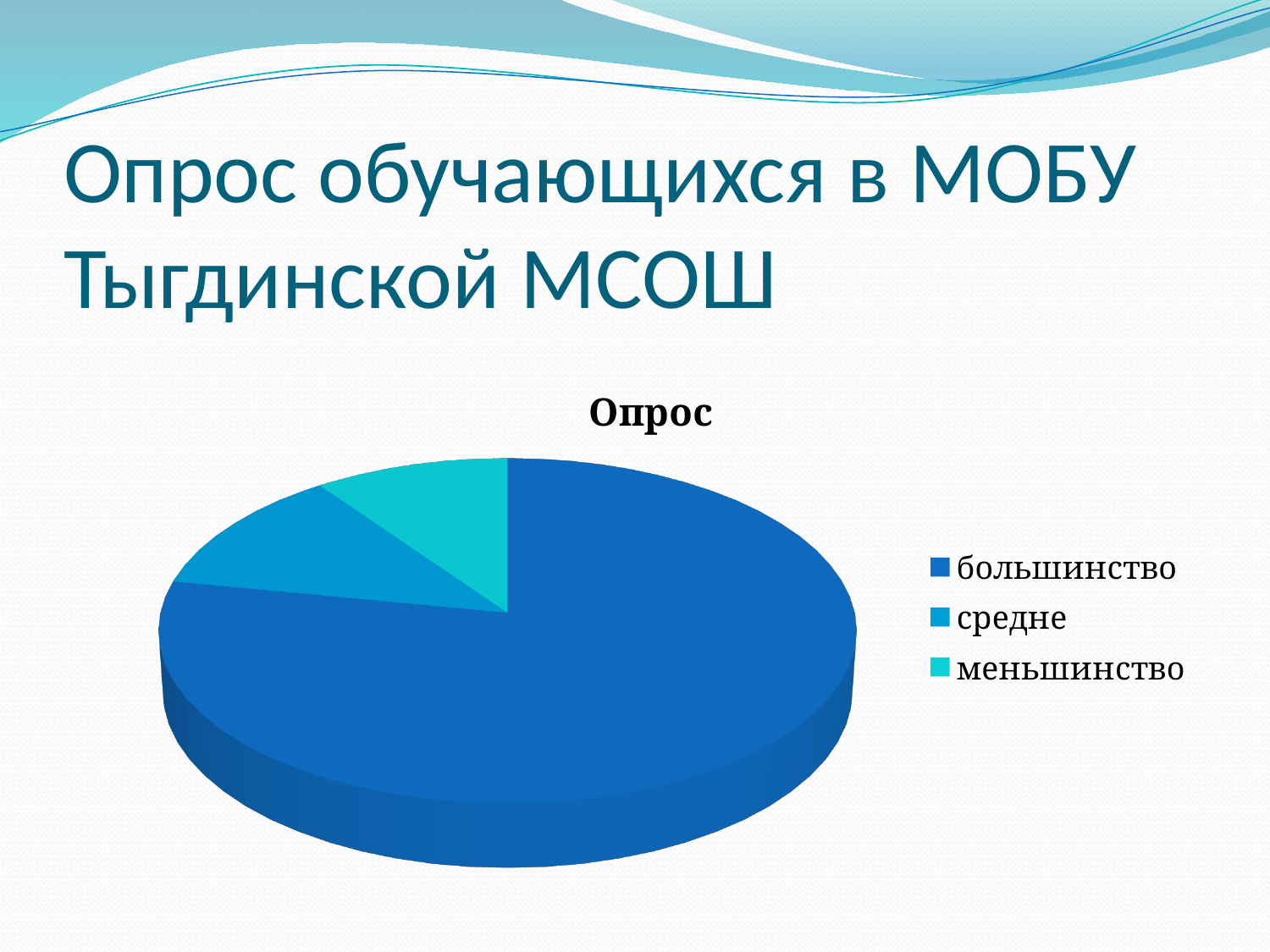
What is the title of the chart? Опрос What kind of chart is shown on the slide? pie chart How many slices does the pie chart have? 3 How many entries does the chart legend list? 3 Which category has the largest slice of the pie? большинство Which is larger, the slice for большинство or the slice for меньшинство? большинство Which is larger, the slice for большинство or the slice for средне? большинство Which legend entry is shown in the lightest (cyan) colour? меньшинство